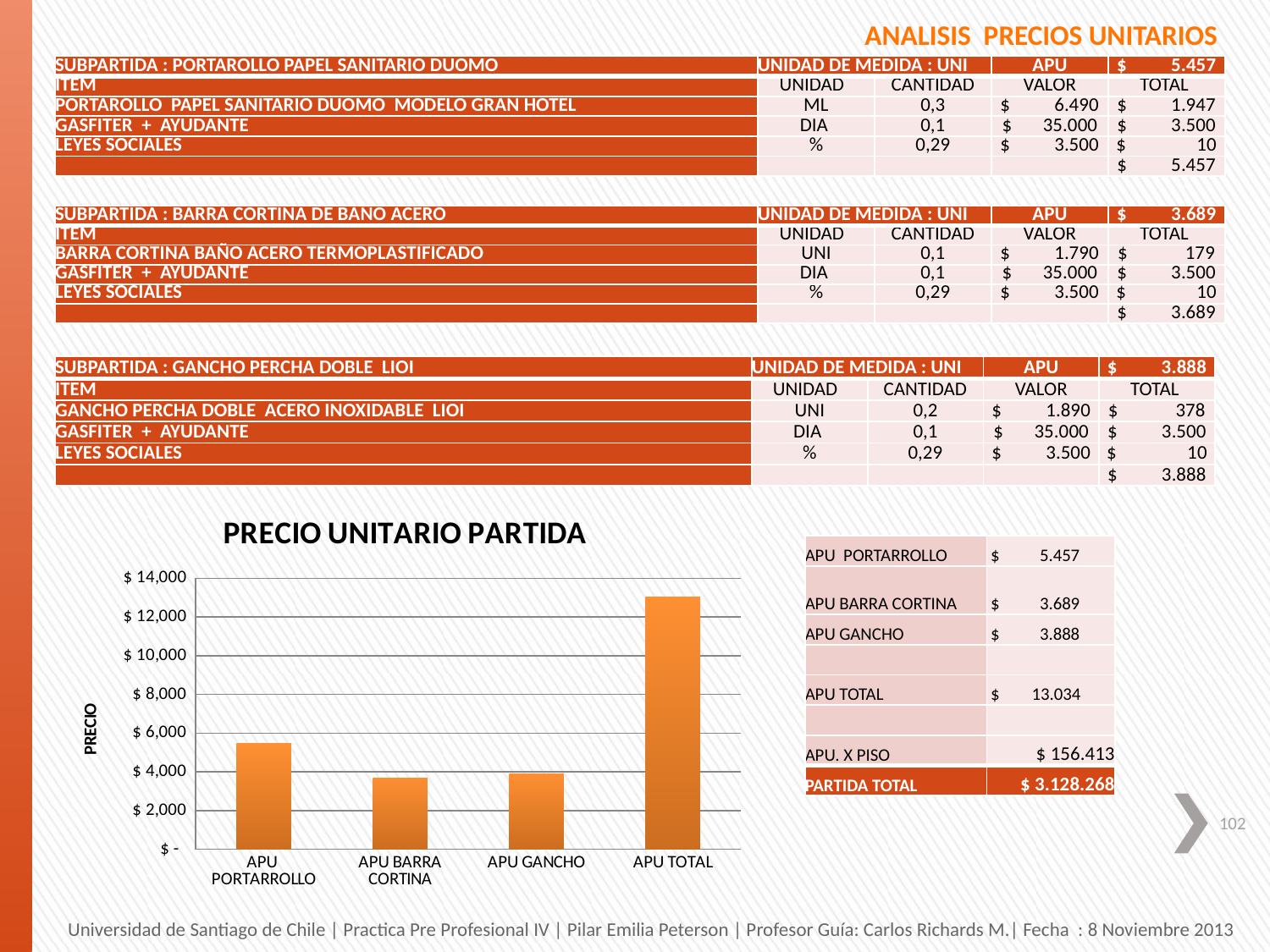
Is the value for APU TOTAL greater or less than $ 12,000? greater How many categories are plotted in the chart? 4 Is the value for APU BARRA CORTINA greater or less than $ 4,000? less Is the value for APU PORTARROLLO greater or less than $ 4,000? greater Which is larger, the value for APU TOTAL or the value for APU PORTARROLLO? APU TOTAL Which is larger, the value for APU PORTARROLLO or the value for APU GANCHO? APU PORTARROLLO What is the title of the chart? PRECIO UNITARIO PARTIDA Which category has the highest bar in the chart? APU TOTAL What kind of chart is shown on the slide? bar chart What is the label on the vertical axis of the chart? PRECIO